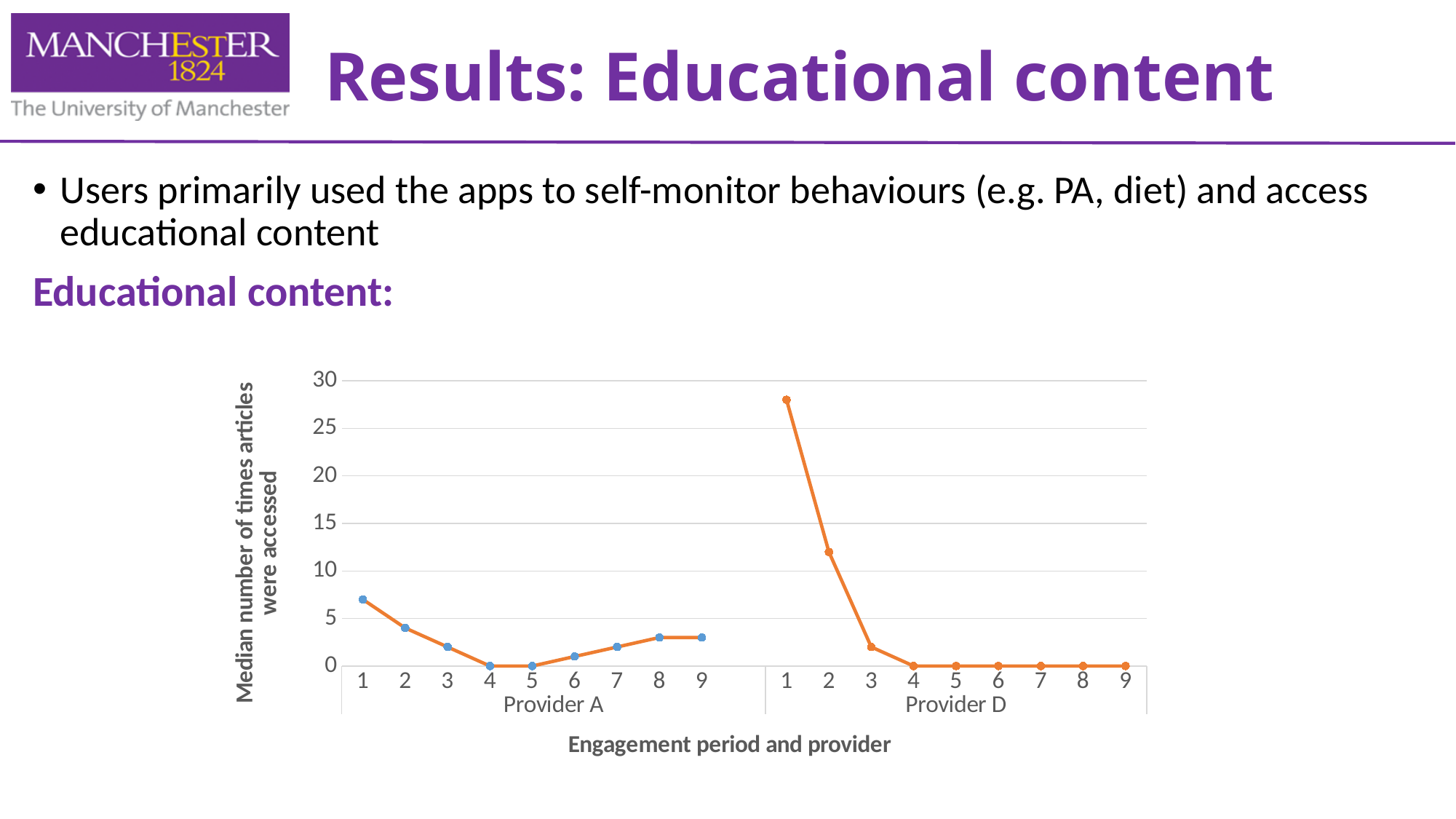
Which provider has the highest value at engagement period 1? Provider D Is the value for Provider D at engagement period 1 greater or less than 25? greater How many engagement periods are plotted for Provider A? 9 Is the value for Provider A at engagement period 1 greater or less than 5? greater Is the value for Provider D at engagement period 2 greater or less than 10? greater How many providers are shown along the x axis? 2 What is the value for Provider D at engagement period 6? 0 What kind of chart is shown on the slide? line chart What is the title of the y axis of the chart? Median number of times articles were accessed What is the value for Provider A at engagement period 4? 0 Do the values for Provider D rise or fall from engagement period 1 to engagement period 4? fall What is the title of the x axis of the chart? Engagement period and provider